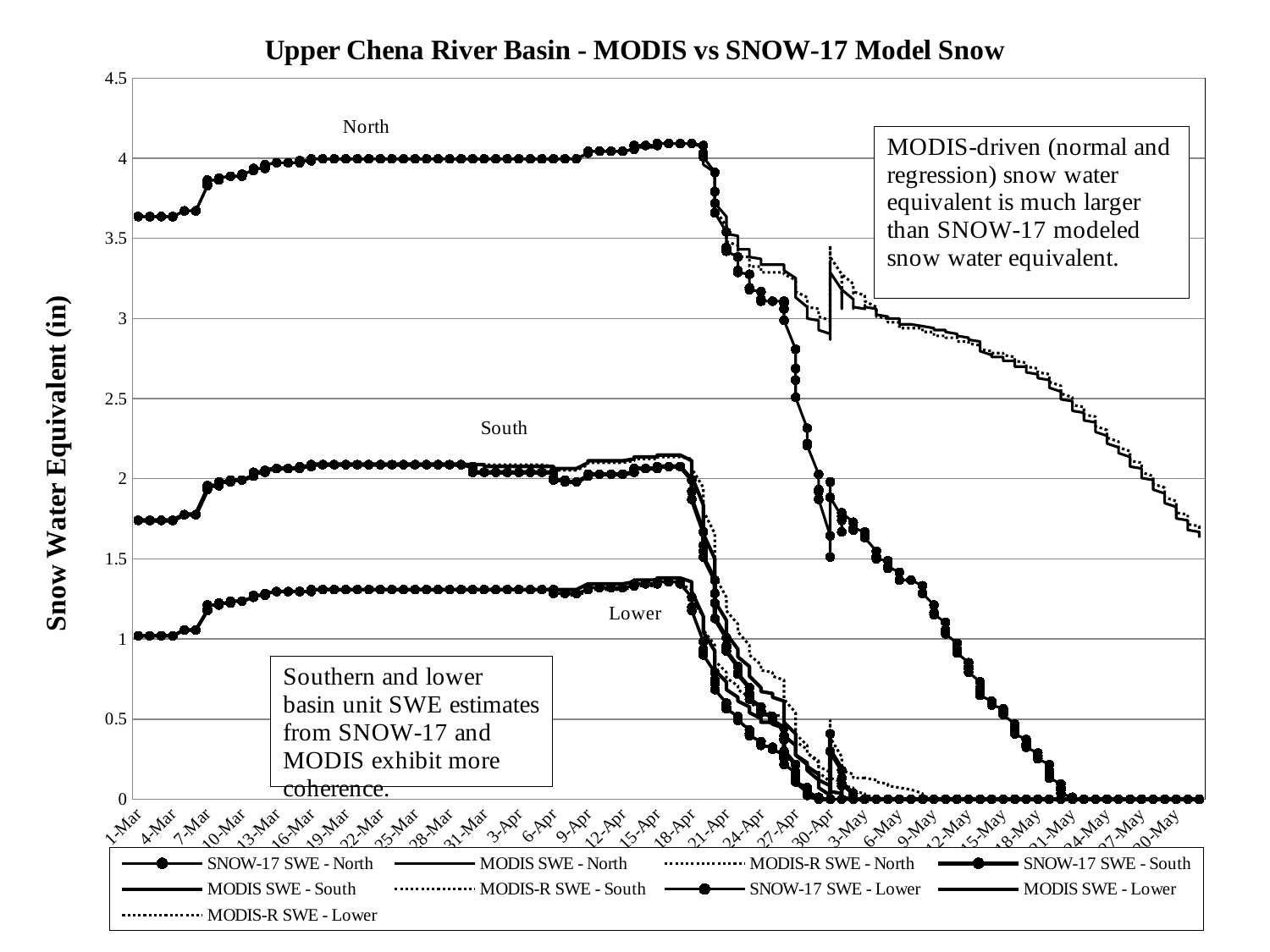
What kind of chart is shown on the slide? line chart Which basin unit (North, South or Lower) has the highest snow water equivalent on 1-Mar? North Is the value for SNOW-17 SWE - Lower on 15-Mar greater or less than 1? greater Is the value for SNOW-17 SWE - South on 1-Mar greater or less than 1.5? greater Is the value for SNOW-17 SWE - North on 1-Mar greater or less than 3.5? greater How many series does the legend list? 9 On 30-May, which is larger: MODIS SWE - North or SNOW-17 SWE - North? MODIS SWE - North Does the SNOW-17 SWE - North series rise or fall between 18-Apr and 21-May? fall What is the label of the vertical axis? Snow Water Equivalent (in) What is the title of the chart? Upper Chena River Basin - MODIS vs SNOW-17 Model Snow